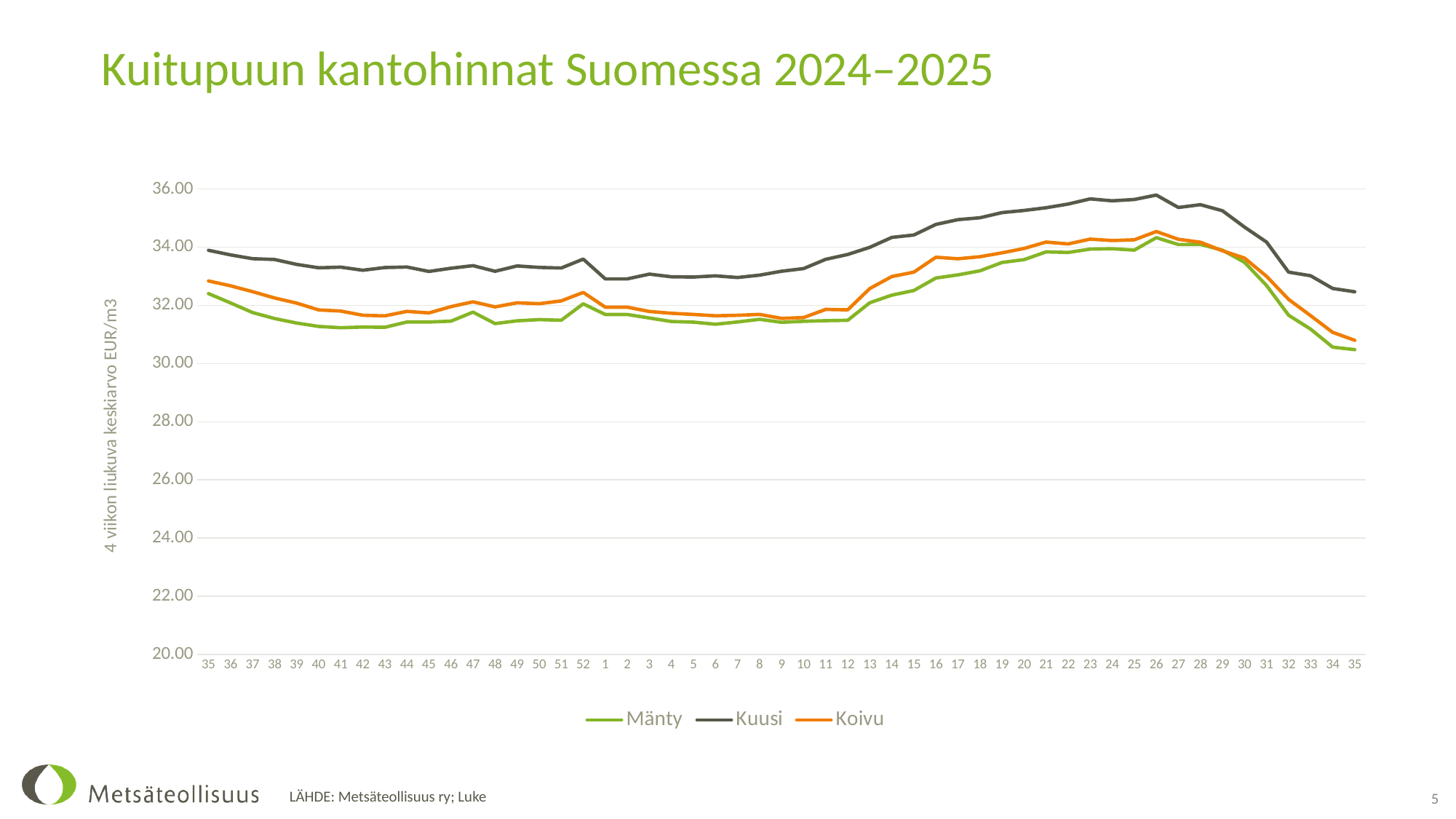
Which series has the lowest value at week 34? Mänty What is the title of the chart? Kuitupuun kantohinnat Suomessa 2024–2025 At week 10, which is higher, Kuusi or Mänty? Kuusi Is the value for Koivu at the first week 35 greater or less than 32.00? greater How many series does the legend list? 3 Do the Kuusi values rise or fall from week 26 to the final week 35? fall What kind of chart is shown on the slide? line chart Is the value for Kuusi at week 26 greater or less than 34.00? greater Is the value for Kuusi at week 1 greater or less than 34.00? less Which series has the highest value at week 26? Kuusi How many weekly points are plotted along the x axis? 53